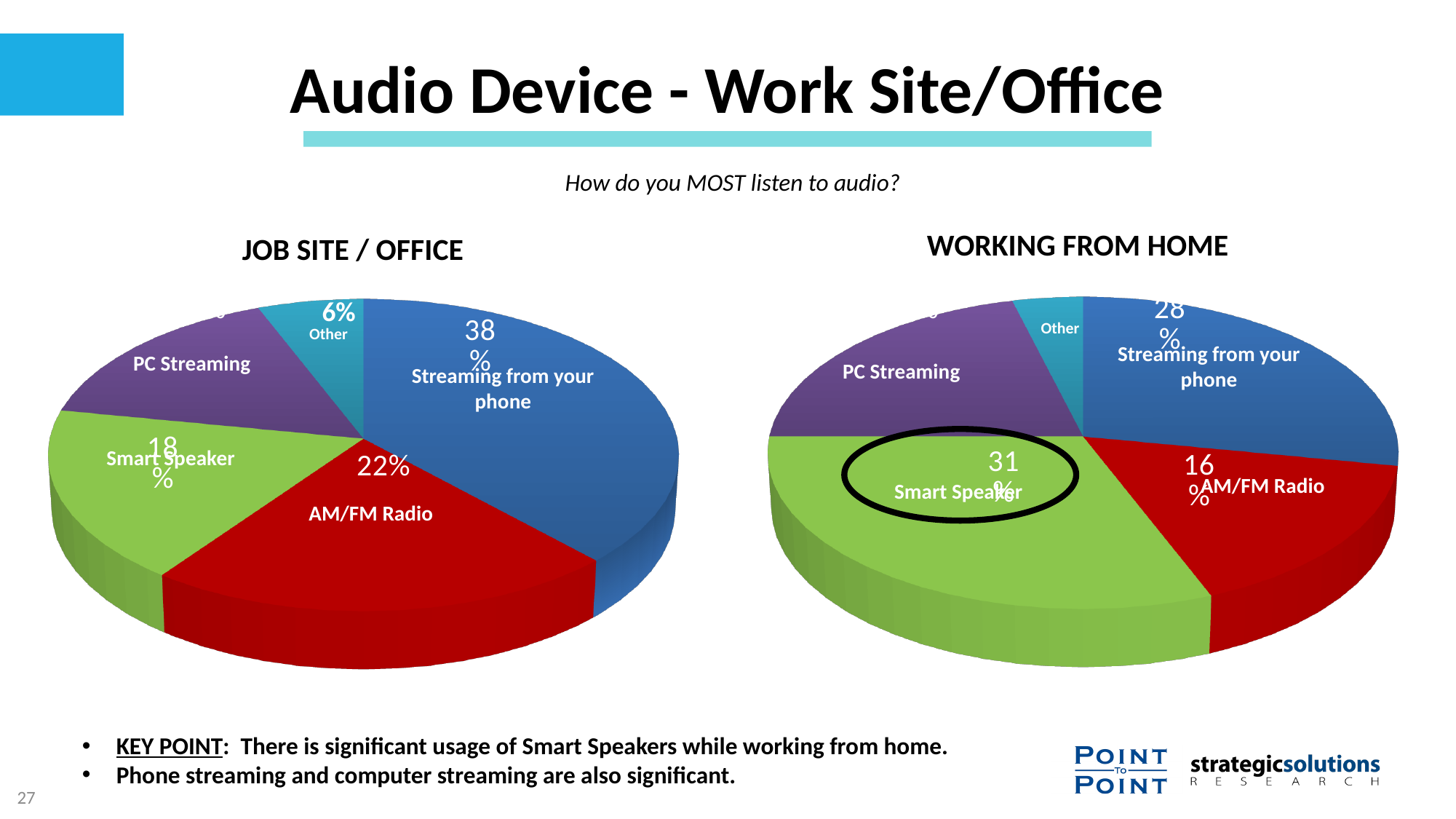
In the JOB SITE / OFFICE pie chart, what percentage is shown for AM/FM Radio? 22% In the WORKING FROM HOME pie chart, which category has the largest share? Smart Speaker In the JOB SITE / OFFICE pie chart, which category has the largest share? Streaming from your phone What type of chart is used for the WORKING FROM HOME data? Pie chart In the JOB SITE / OFFICE pie chart, what percentage is shown for Streaming from your phone? 38% In the JOB SITE / OFFICE pie chart, what percentage is shown for Smart Speaker? 18% In the WORKING FROM HOME pie chart, what percentage is shown for Smart Speaker? 31% Is the AM/FM Radio share larger in the JOB SITE / OFFICE chart or the WORKING FROM HOME chart? JOB SITE / OFFICE In the WORKING FROM HOME pie chart, what percentage is shown for Streaming from your phone? 28% In the JOB SITE / OFFICE pie chart, how many percentage points larger is Streaming from your phone than AM/FM Radio? 16 In the JOB SITE / OFFICE pie chart, what percentage is shown for Other? 6% In the WORKING FROM HOME pie chart, what percentage is shown for AM/FM Radio? 16%